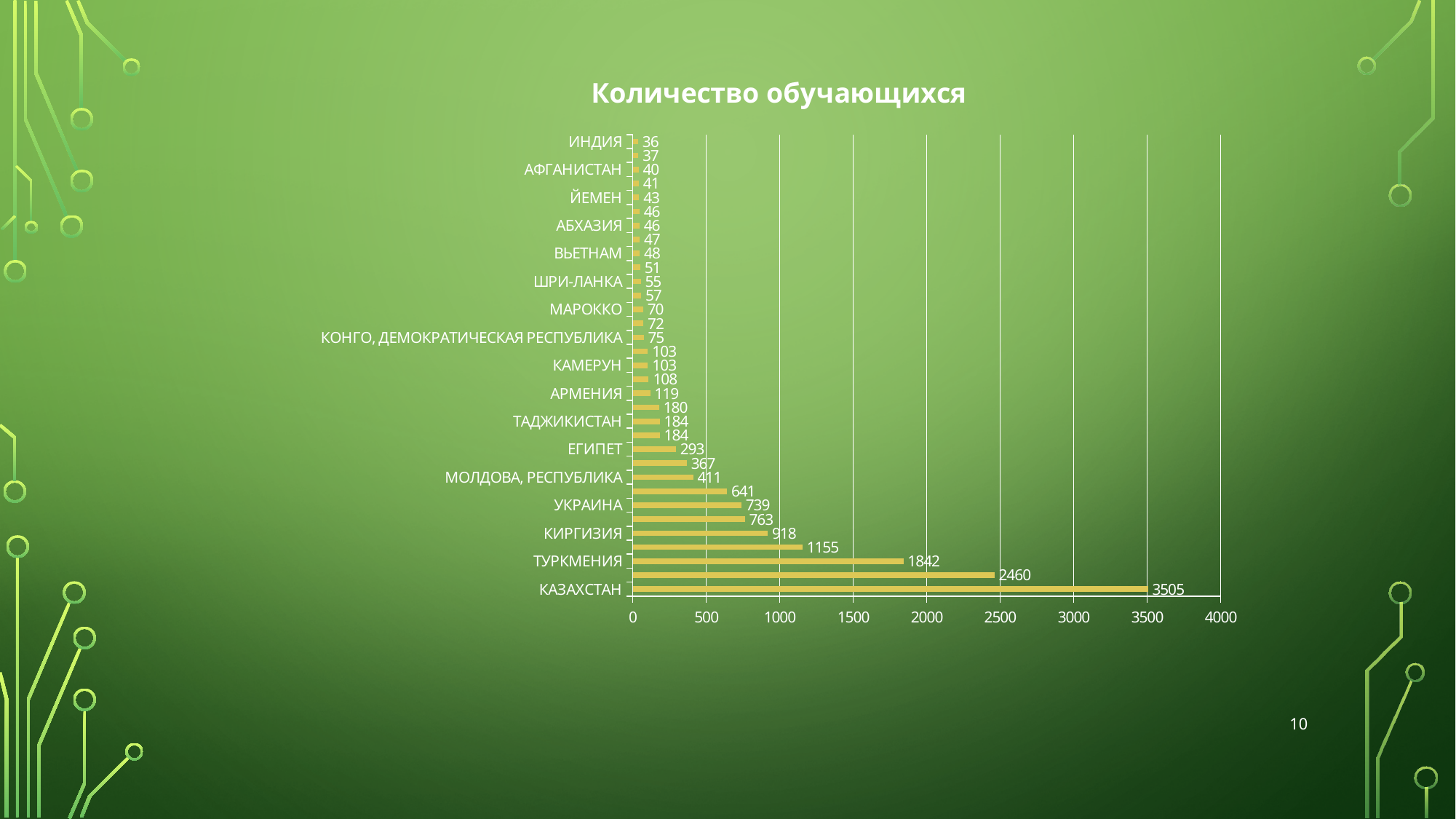
What is the difference between the values for КАЗАХСТАН and ТУРКМЕНИЯ? 1663 Which category has the highest value? КАЗАХСТАН What is the difference between the values for КИРГИЗИЯ and УКРАИНА? 179 What is the value for ТУРКМЕНИЯ? 1842 What is the title of the chart? Количество обучающихся What is the value for АРМЕНИЯ? 119 What is the value for КАЗАХСТАН? 3505 What is the value for ЕГИПЕТ? 293 Which is larger, the value for КИРГИЗИЯ or the value for УКРАИНА? КИРГИЗИЯ Which labelled category has the lowest value? ИНДИЯ What is the value for УКРАИНА? 739 What kind of chart is shown on the slide? Bar chart